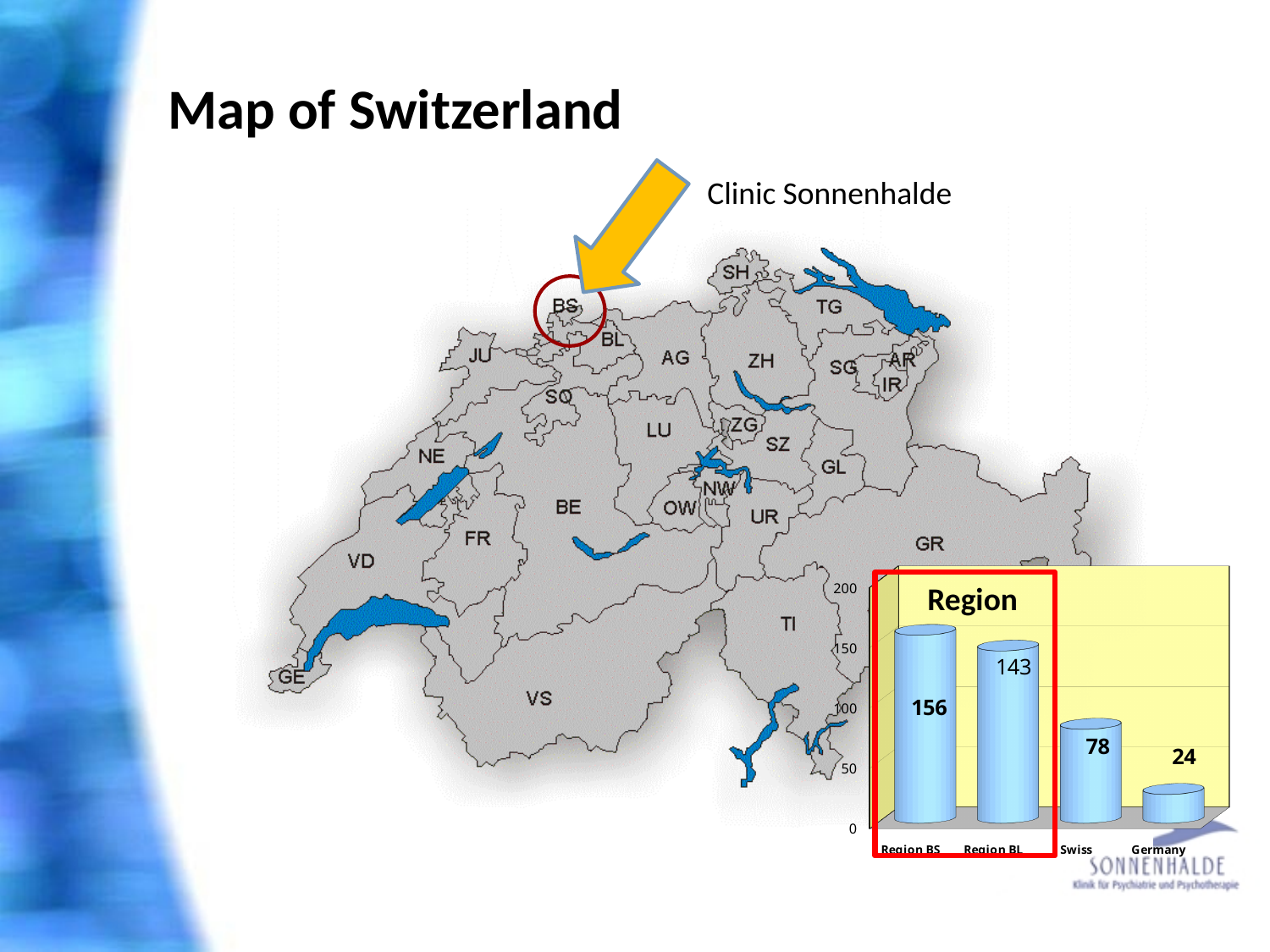
What is the value for Germany in the bar chart? 24 Which category has the highest value in the bar chart? Region BS Which category has the lowest value in the bar chart? Germany Is the value for Region BL greater or less than 100? greater What is the value for Swiss in the bar chart? 78 What is the value for Region BL in the bar chart? 143 What kind of chart is shown on the slide? bar chart What is the value for Region BS in the bar chart? 156 What is the difference between the values for Region BS and Region BL? 13 How many categories are shown in the bar chart? 4 What is the difference between the values for Swiss and Germany? 54 Which is larger, the value for Swiss or the value for Germany? Swiss